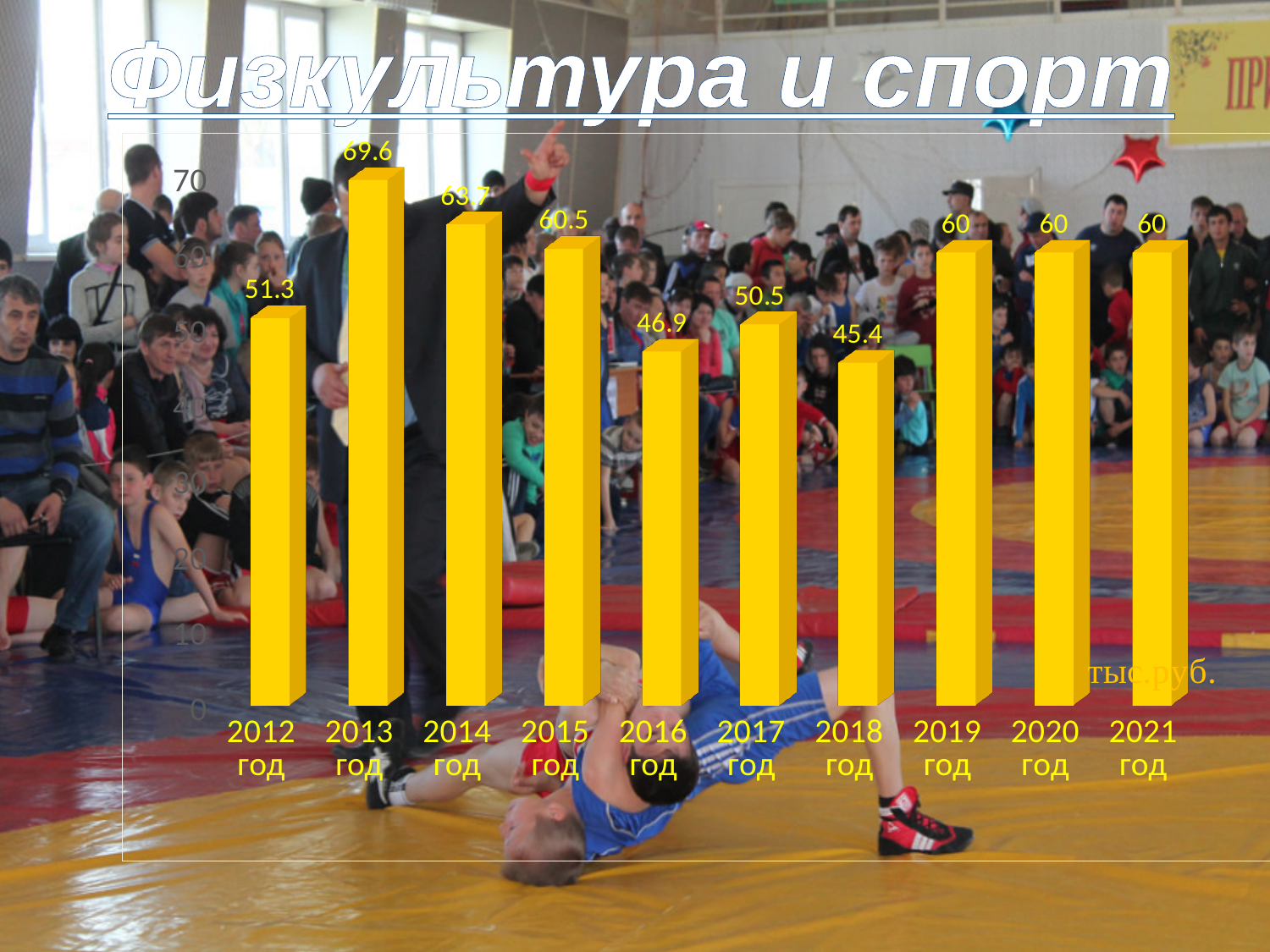
What kind of chart is shown on the slide? bar chart Which year has the highest value? 2013 год What is the value for 2013 год? 69.6 What is the title of the slide? Физкультура и спорт Which year has the lowest value? 2018 год Is the value for 2017 год greater or less than 60? less Do the values rise or fall from 2013 год to 2016 год? fall What is the difference between the values for 2013 год and 2012 год? 18.3 Which is larger, the value for 2014 год or the value for 2015 год? 2014 год What is the value for 2018 год? 45.4 What is the value for 2016 год? 46.9 How many years are shown on the x axis? 10